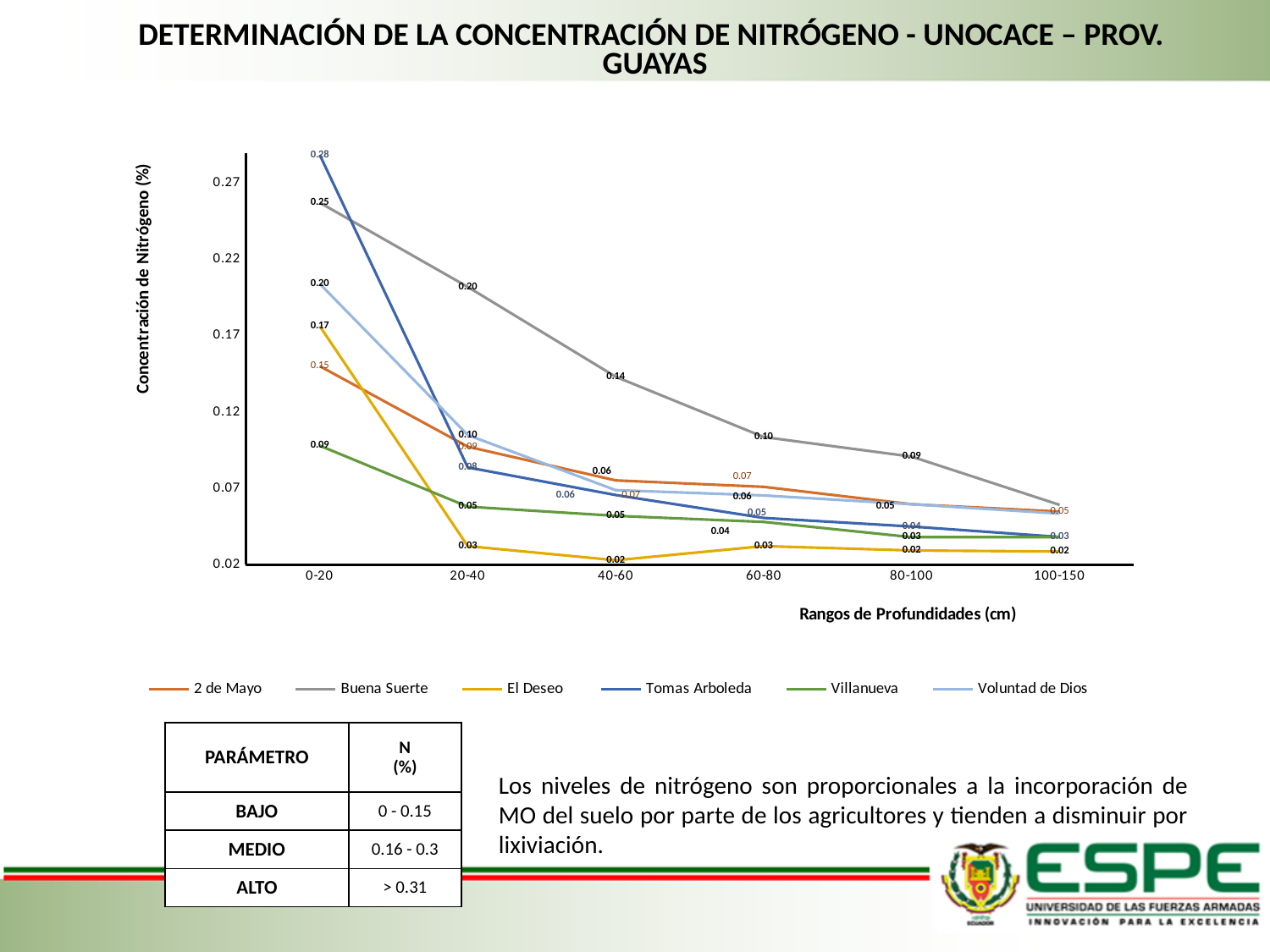
What is the nitrogen concentration for Buena Suerte at the 40-60 depth range? 0.14 What kind of chart is shown on the slide? line chart What is the nitrogen concentration for Buena Suerte at the 60-80 depth range? 0.10 Which series has the lowest value at the 0-20 depth range? Villanueva Which is larger at the 40-60 depth range, Buena Suerte or Villanueva? Buena Suerte How many depth ranges are shown on the x axis? 6 What is the nitrogen concentration for Tomas Arboleda at the 0-20 depth range? 0.28 Does the Buena Suerte series rise or fall as depth increases along the x axis? fall What is the difference between Tomas Arboleda and Buena Suerte at the 0-20 depth range? 0.03 What is the title of the x axis? Rangos de Profundidades (cm) Which series has the highest value at the 0-20 depth range? Tomas Arboleda How many series does the legend list? 6